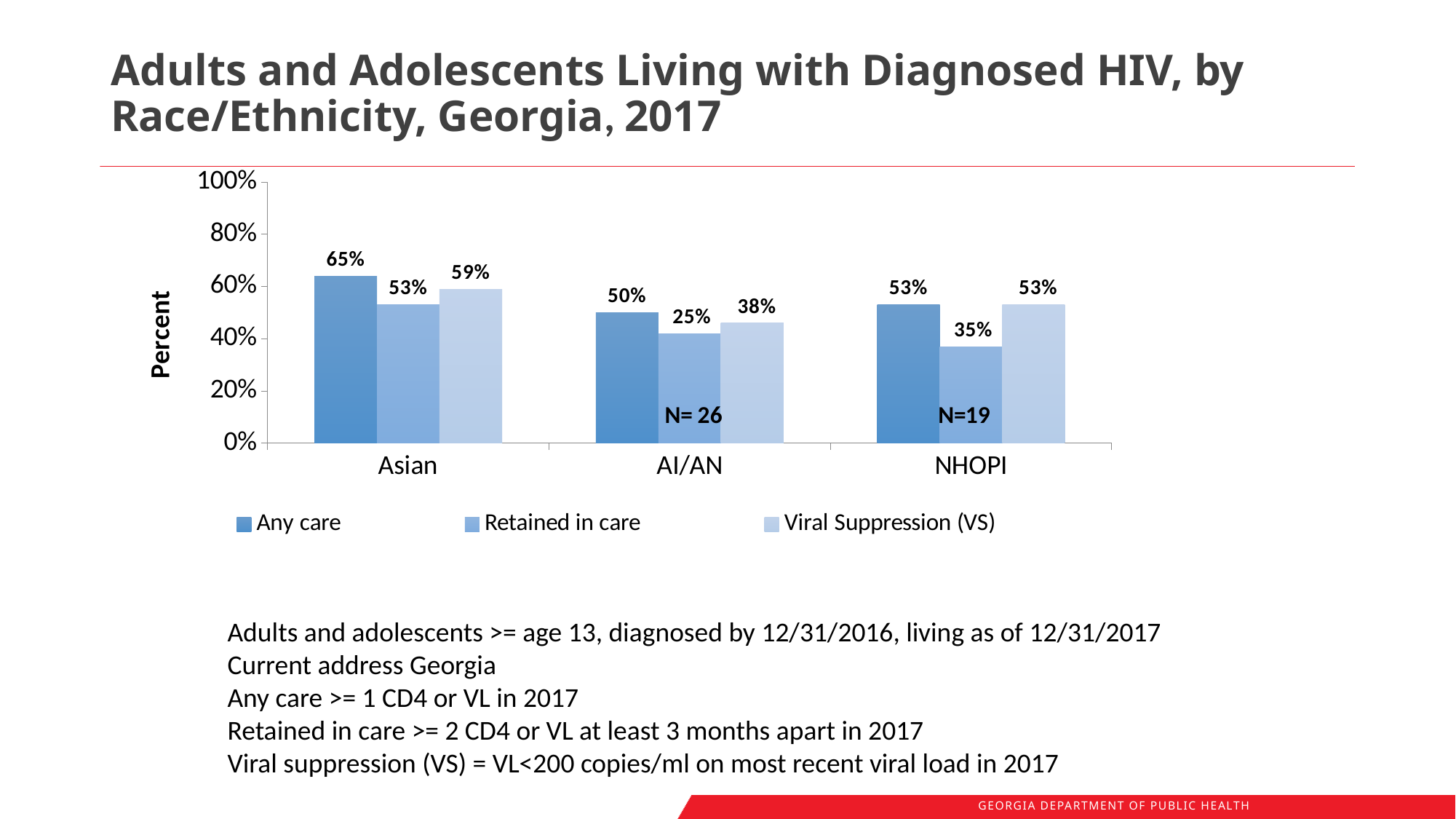
What kind of chart is shown on the slide? Bar chart Which race/ethnicity group has the lowest Retained in care value? AI/AN How many series does the legend list? 3 Which race/ethnicity group has the highest Any care value? Asian What is the difference between the Retained in care values for NHOPI and AI/AN? 10% What is the Any care value for Asian? 65% What is the difference between the Any care values for Asian and AI/AN? 15% What is the Viral Suppression (VS) value for NHOPI? 53% Which is larger, the Viral Suppression (VS) value for Asian or for NHOPI? Asian What is the Viral Suppression (VS) value for AI/AN? 38% How many race/ethnicity categories are shown on the x axis? 3 What is the Retained in care value for AI/AN? 25%